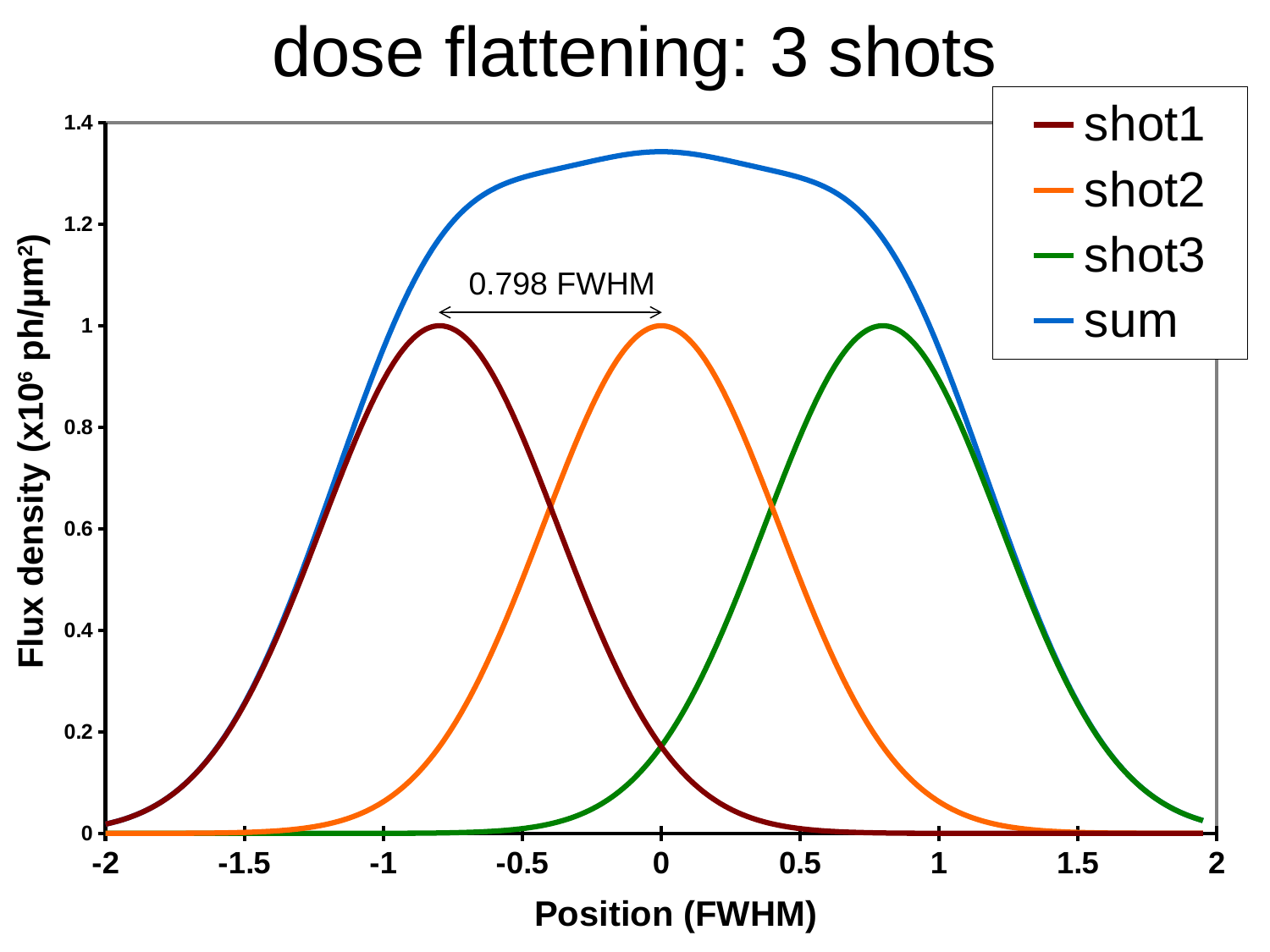
What kind of chart is shown on the slide? line chart What is the label of the x axis? Position (FWHM) Does the sum curve rise or fall as position goes from -2 to 0? rise At position 0, which is larger, the sum curve or the shot2 curve? sum Does the shot1 curve rise or fall as position goes from -0.5 to 0.5? fall What spacing between shots is annotated on the chart? 0.798 FWHM How many series does the legend list? 4 Is the value of the sum curve at position 0 greater or less than 1.2? greater What is the title of the chart? dose flattening: 3 shots Is the value of the shot3 curve at position -1 greater or less than 0.2? less What is the peak value of the shot2 curve? 1 Which series reaches the highest value on the chart? sum